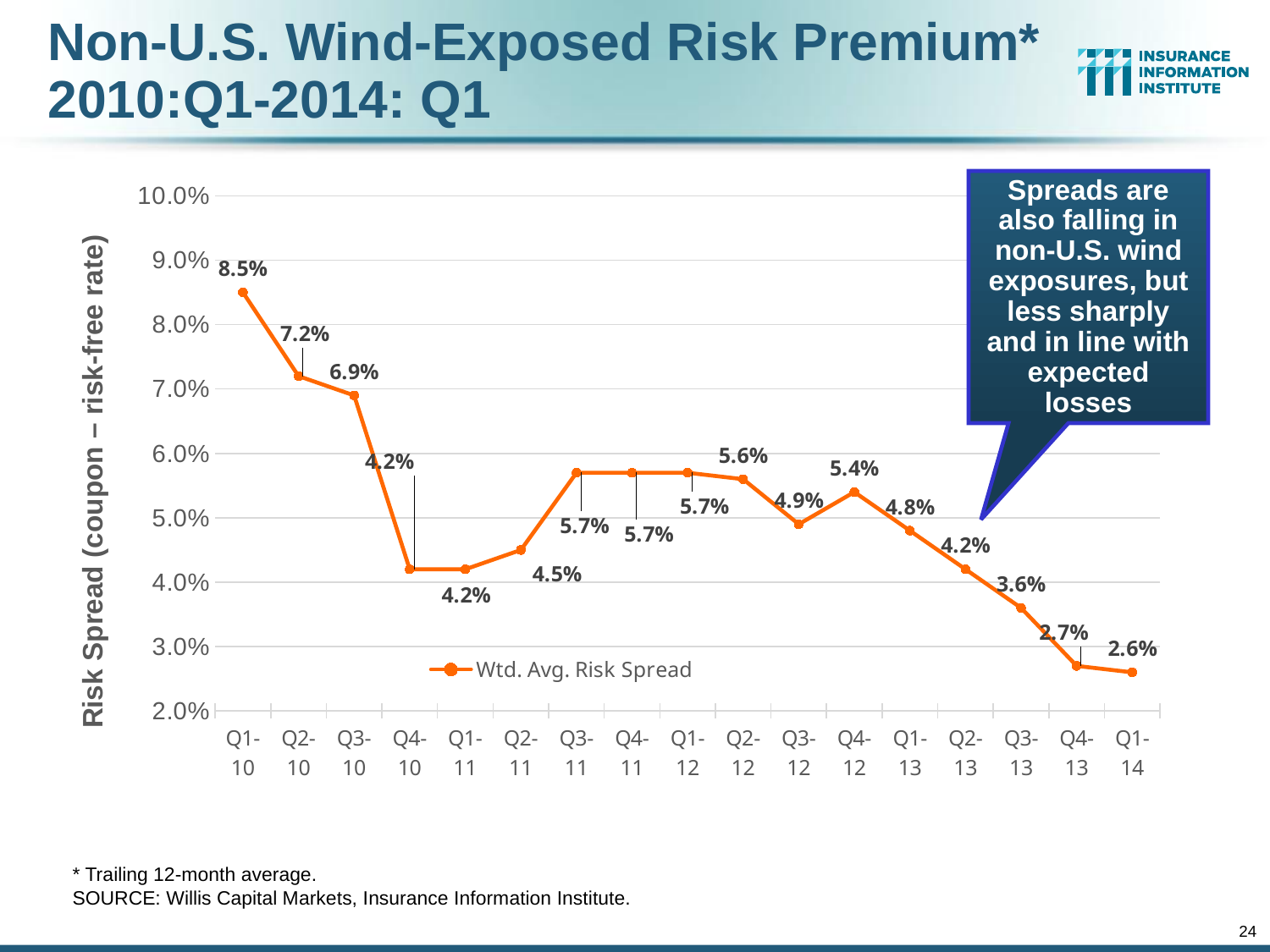
Which quarter had the lowest weighted average risk spread? Q1-14 Which quarter had the highest weighted average risk spread? Q1-10 What is the difference between the risk spread in Q1-10 and Q1-14? 5.9% How many quarterly data points are plotted on the chart? 17 What is the name of the series shown in the legend? Wtd. Avg. Risk Spread What is the overall trend of the risk spread from Q1-10 to Q1-14? Falling What was the weighted average risk spread in Q1-10? 8.5% Which is larger, the risk spread in Q3-10 or in Q3-13? Q3-10 What was the weighted average risk spread in Q4-12? 5.4% What was the weighted average risk spread in Q1-14? 2.6% How many series does the legend list? 1 What type of chart is shown on the slide? Line chart